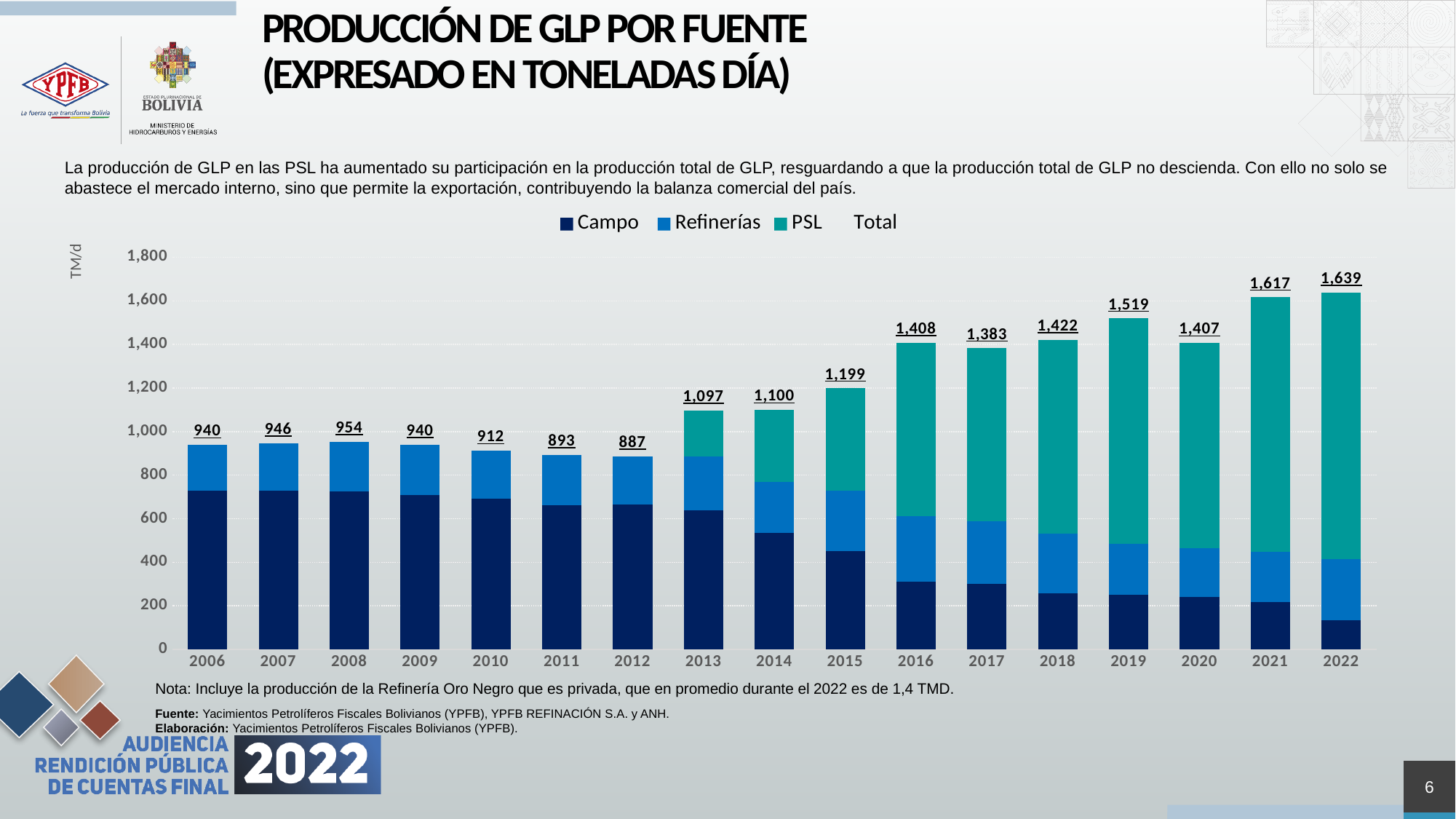
What is the total GLP production shown for 2022? 1,639 Is the Campo value for 2006 greater or less than 600? greater What is the total value labelled for 2010? 912 Which year has the highest total GLP production? 2022 Which year has the lowest total GLP production? 2012 Is the Campo value for 2022 greater or less than 200? less What is the difference between the total for 2016 and the total for 2015? 209 What is the difference between the total for 2022 and the total for 2021? 22 What is the total value labelled for 2013? 1,097 How many years are shown on the x axis? 17 How many entries does the legend list? 4 Which year has a larger total, 2018 or 2019? 2019